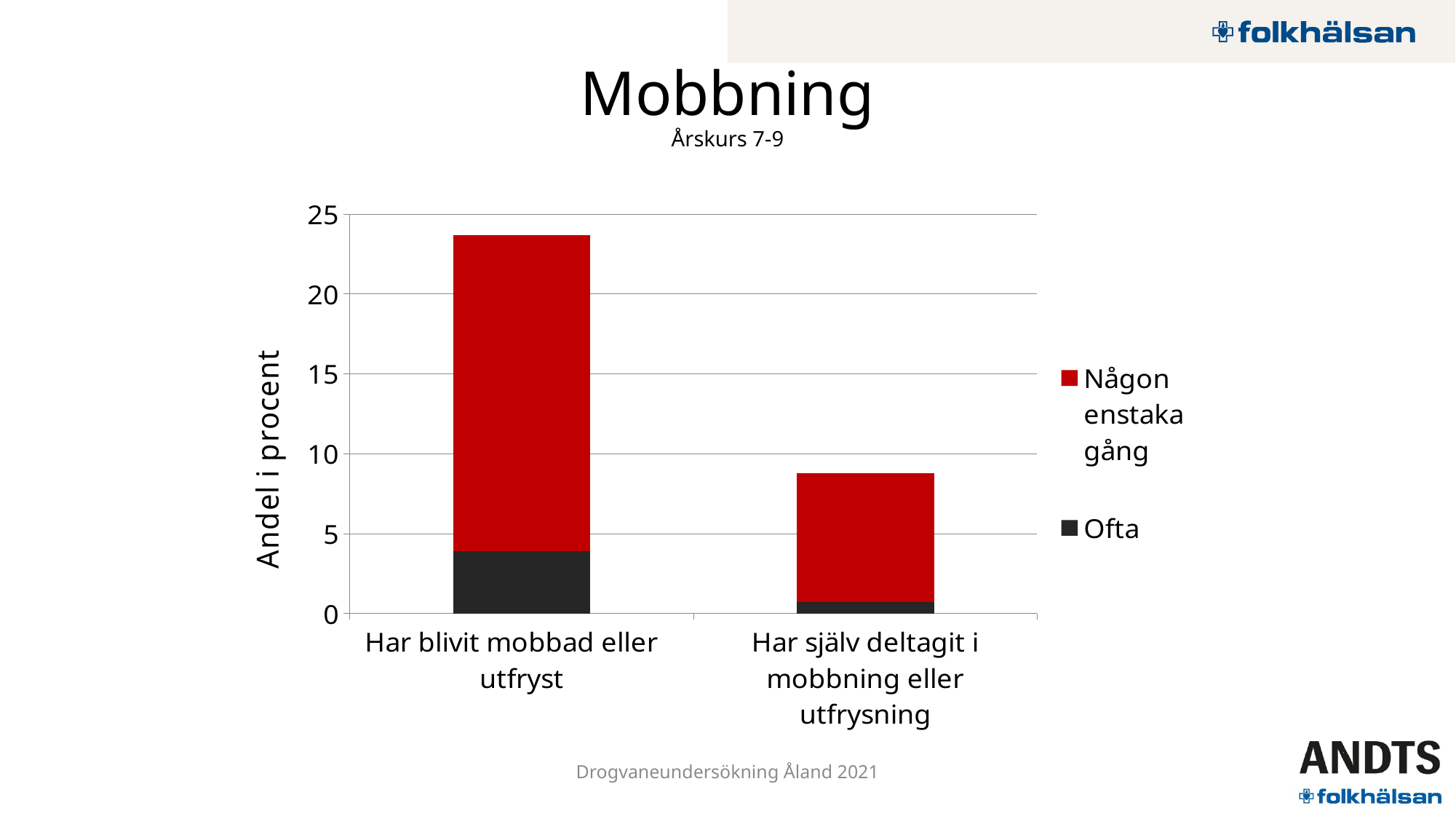
Is the "Ofta" value for "Har blivit mobbad eller utfryst" greater or less than 5? less Is the total stacked value for "Har själv deltagit i mobbning eller utfrysning" greater or less than 10? less How many series does the legend list? 2 How many categories are shown on the x axis? 2 Is the "Någon enstaka gång" segment for "Har blivit mobbad eller utfryst" greater or less than 15? greater Which category has the taller stacked bar? Har blivit mobbad eller utfryst What kind of chart is shown on the slide? stacked bar chart What is the label on the y axis? Andel i procent What is the title of the chart? Mobbning Which category has the shorter stacked bar? Har själv deltagit i mobbning eller utfrysning Which is larger for "Har själv deltagit i mobbning eller utfrysning": the "Ofta" segment or the "Någon enstaka gång" segment? Någon enstaka gång